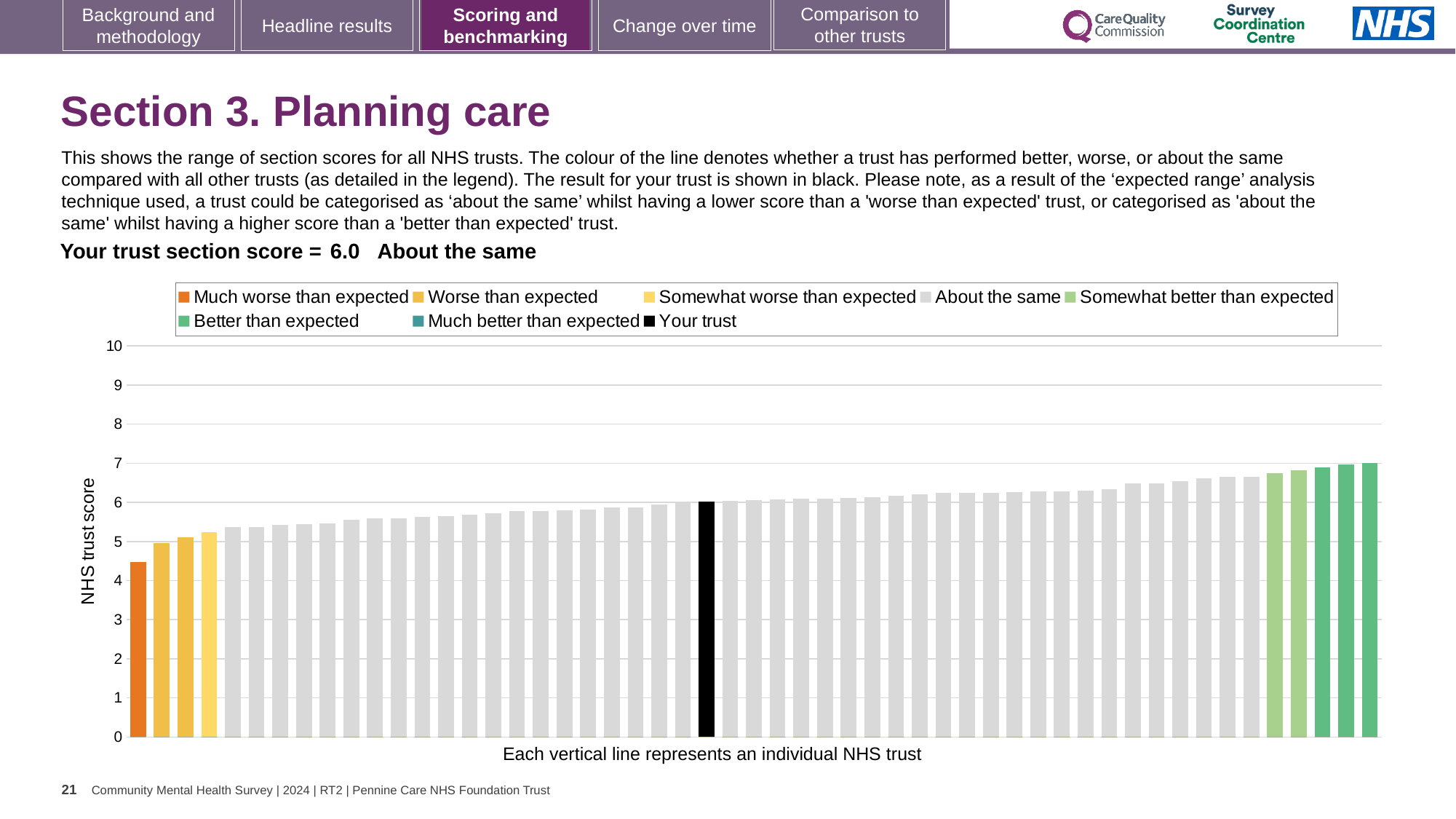
Is the value of the black 'Your trust' bar greater or less than 5? greater What kind of chart is shown on the slide? bar chart How many entries does the chart legend list? 8 Is the value of the leftmost (orange) bar greater or less than 5? less How many bars are coloured black? 1 Which performance category is the trust's section score placed in? About the same Is the value of the rightmost bar greater or less than 6? greater What is the trust's section score for Section 3, Planning care? 6.0 Which colour does the legend use for 'Your trust'? black How many bars are coloured orange ('Much worse than expected')? 1 What is the label on the vertical axis of the chart? NHS trust score Do the bar values rise or fall from left to right across the chart? rise